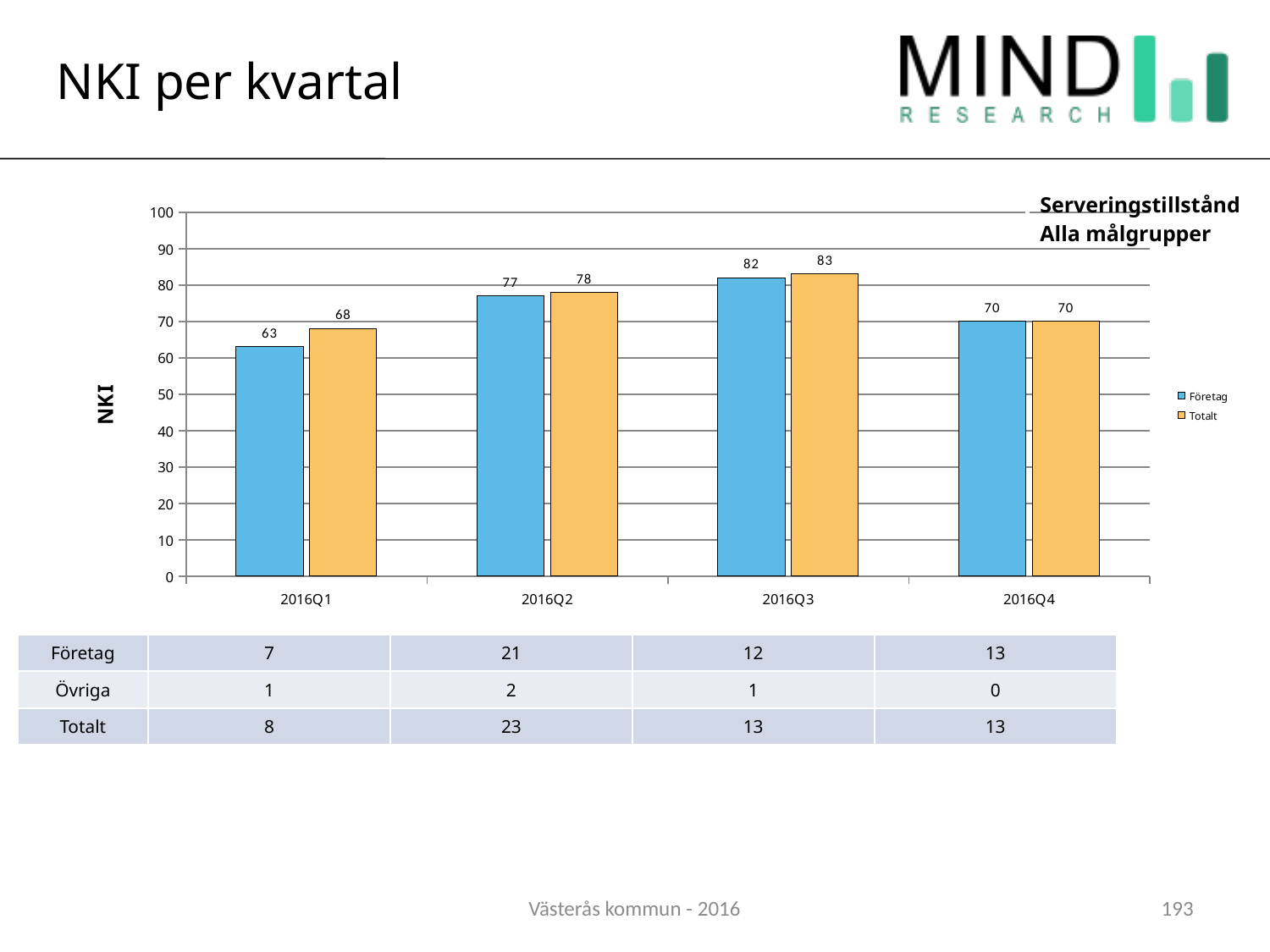
What is the NKI value for Totalt in 2016Q4? 70 What is the label on the y axis of the chart? NKI Which is larger, the Företag NKI value in 2016Q2 or in 2016Q4? 2016Q2 What kind of chart is shown on the slide? Bar chart In which quarter is the Företag NKI value highest? 2016Q3 What is the NKI value for Företag in 2016Q1? 63 What is the NKI value for Totalt in 2016Q3? 83 In which quarter is the Totalt NKI value lowest? 2016Q1 How many quarters are shown on the x axis of the chart? 4 Does the Företag NKI value rise or fall from 2016Q3 to 2016Q4? Fall What is the difference between the Totalt and Företag NKI values in 2016Q1? 5 How many series does the chart legend list? 2